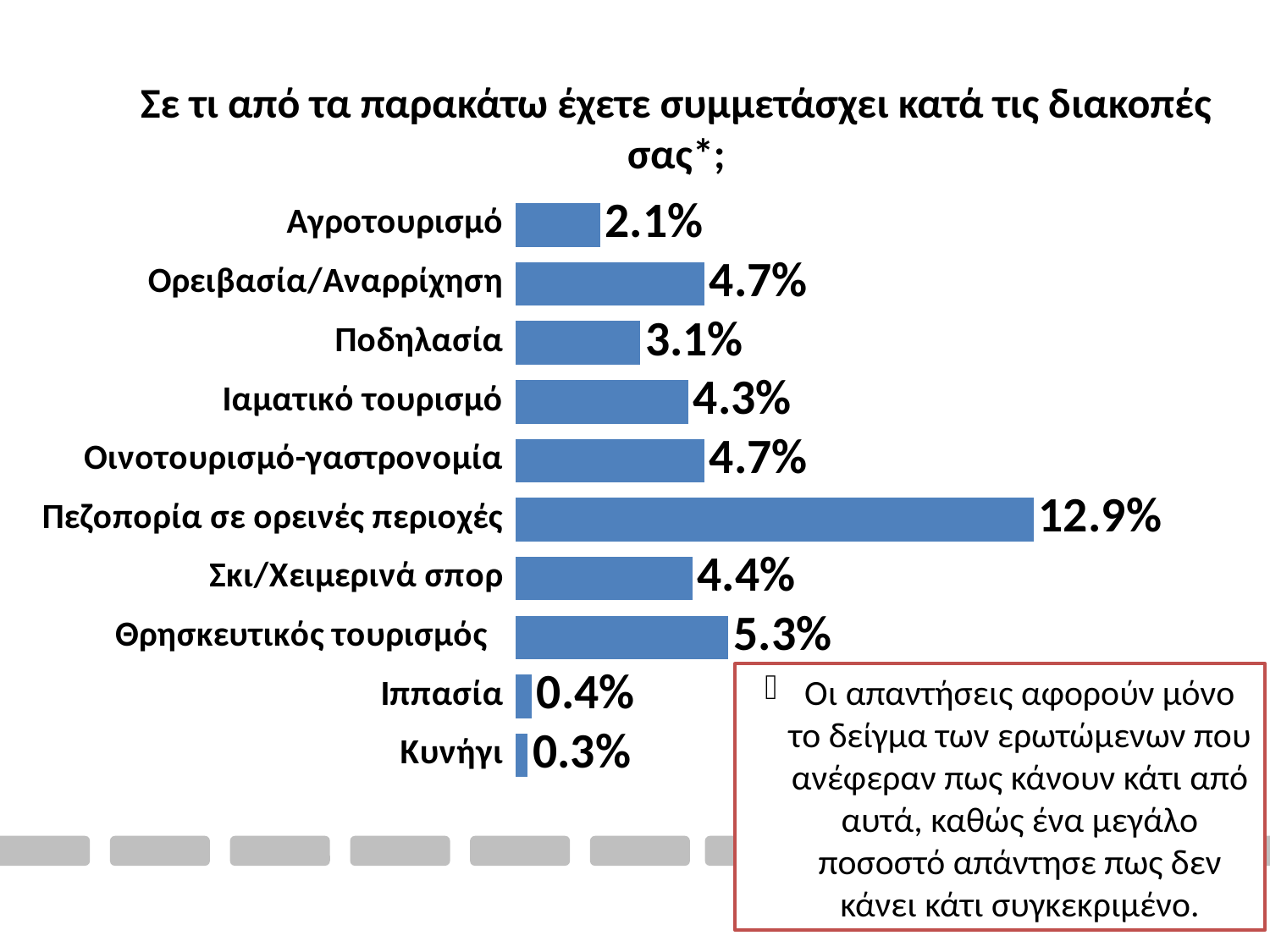
What is the value for Πεζοπορία σε ορεινές περιοχές? 12.9% Which is larger, the value for Ποδηλασία or the value for Ιαματικό τουρισμό? Ιαματικό τουρισμό What is the difference between the values for Πεζοπορία σε ορεινές περιοχές and Θρησκευτικός τουρισμός? 7.6% Which two categories both have a value of 4.7%? Ορειβασία/Αναρρίχηση and Οινοτουρισμό-γαστρονομία What is the difference between the values for Ορειβασία/Αναρρίχηση and Αγροτουρισμό? 2.6% What is the value for Ιππασία? 0.4% How many categories are shown in the chart? 10 Which category has the highest value? Πεζοπορία σε ορεινές περιοχές What kind of chart is shown on the slide? Bar chart Which category has the lowest value? Κυνήγι What is the value for Αγροτουρισμό? 2.1% What is the value for Θρησκευτικός τουρισμός? 5.3%